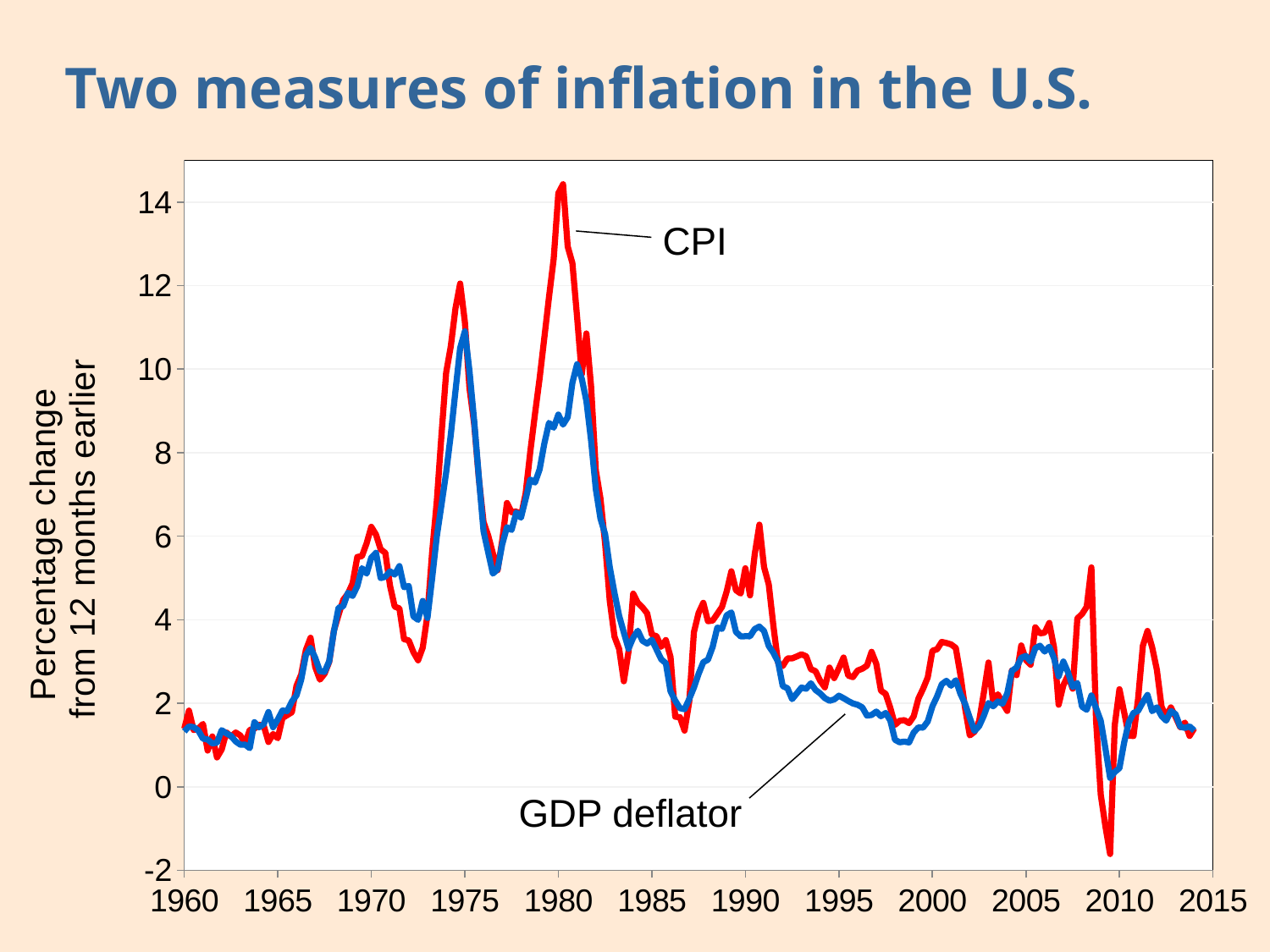
Does the CPI line rise or fall between 1980 and 1985? fall Which series is higher at its peak around 1990, CPI or GDP deflator? CPI Is the peak value of CPI around 1980 greater or less than 12? greater What colour is the CPI line? red How many series are plotted on the chart? 2 Is the lowest value of CPI around 2009 greater or less than 0? less Which series reaches the higher peak around 1980, CPI or GDP deflator? CPI What is the title of the slide's chart? Two measures of inflation in the U.S. Is the value of CPI at its 1975 peak greater or less than 10? greater Around which labeled year does CPI reach its highest value? 1980 What kind of chart is shown on the slide? line chart